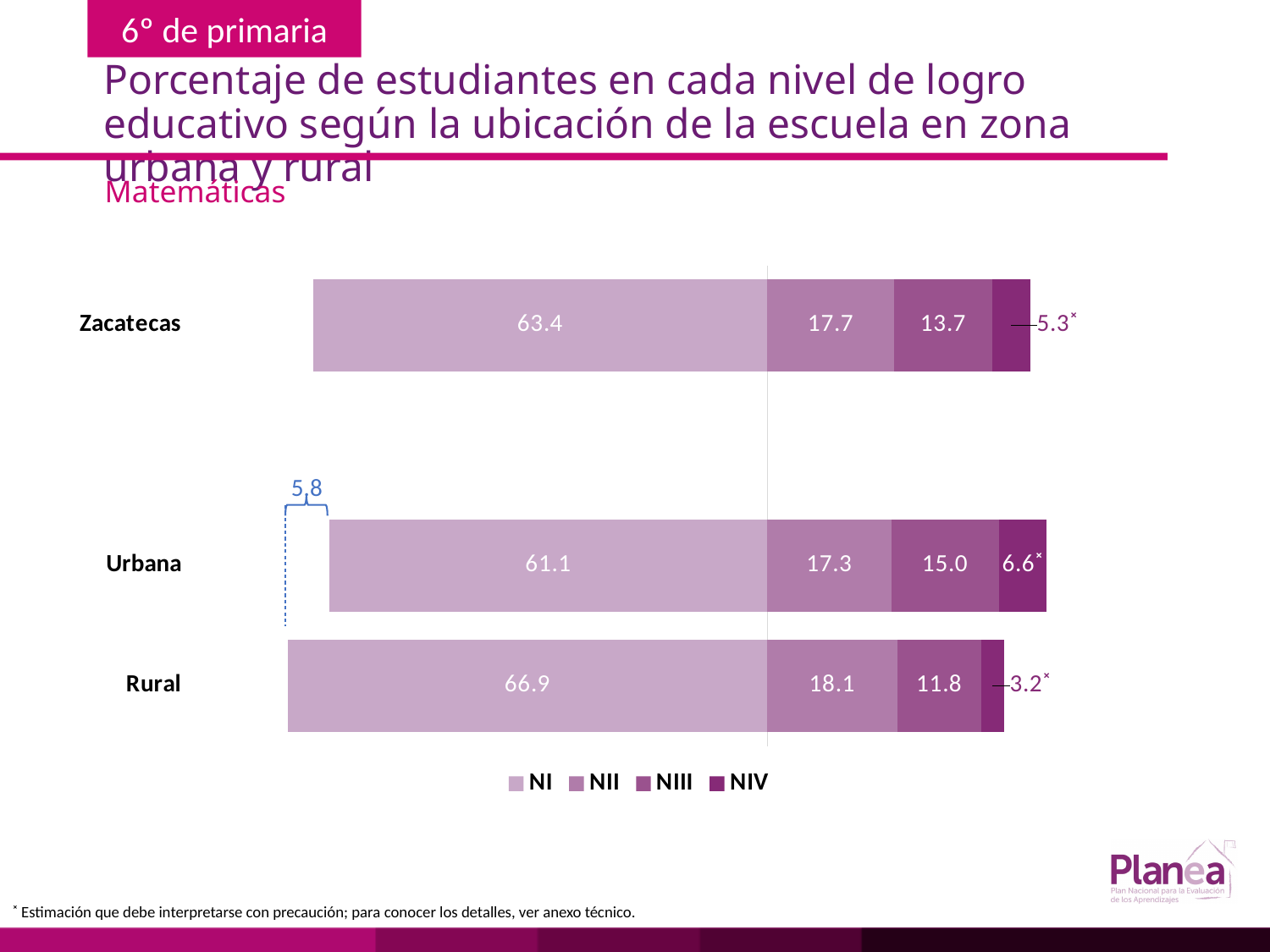
What is the NIII value for Urbana? 15.0 What type of chart is shown on the slide? stacked bar chart How many categories (bars) are shown in the chart? 3 What is the NI value for Zacatecas? 63.4 What is the NIV value for Rural? 3.2 What is the NII value for Rural? 18.1 Which category has the lowest NIV value? Rural Which is larger, the NIII value for Zacatecas or the NIII value for Rural? Zacatecas Which category has the highest NI value? Rural How many series does the legend list? 4 What is the difference between the NI values for Rural and Urbana? 5.8 What is the total of the stacked bar for Urbana? 100.0